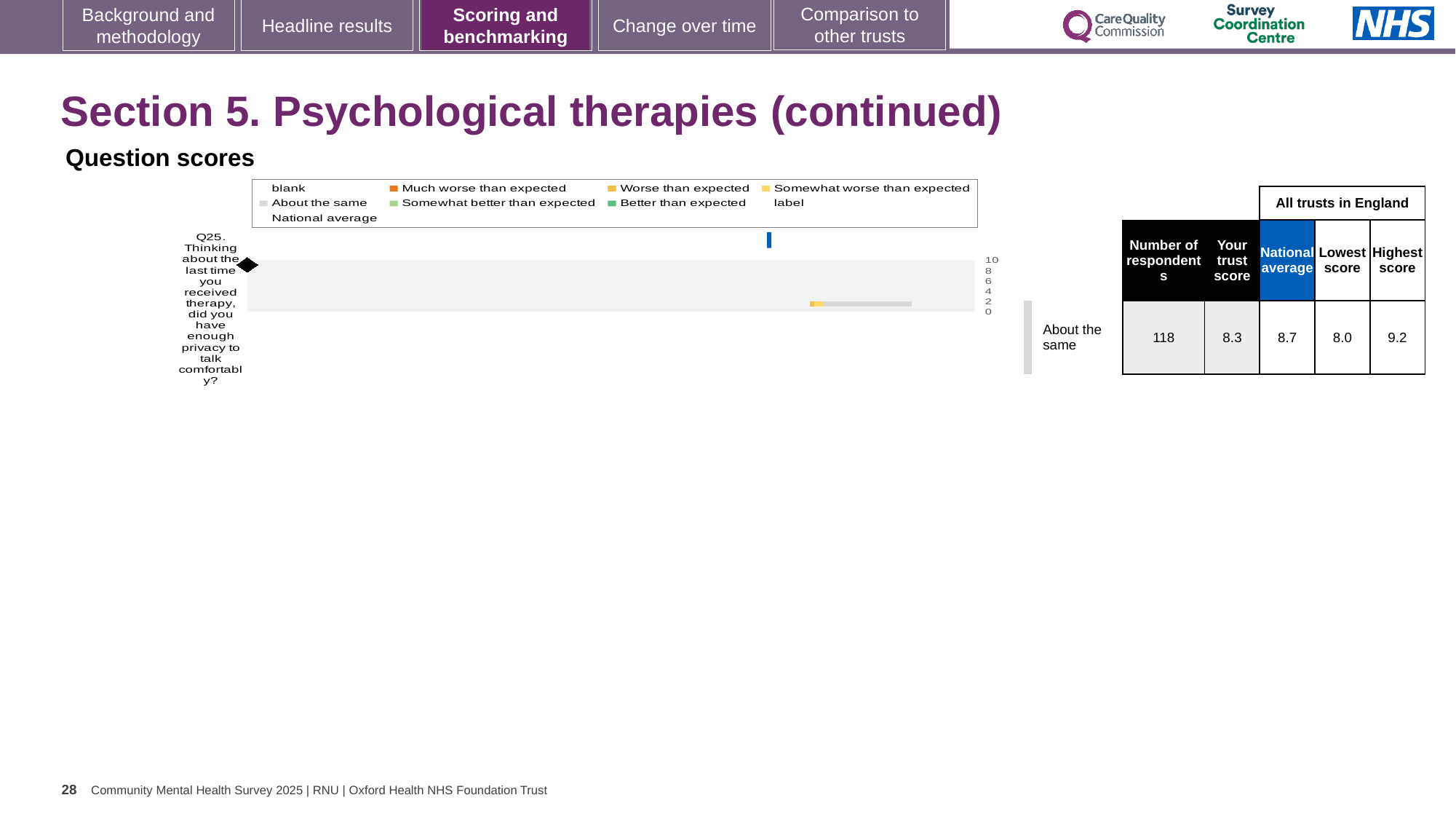
What is the difference between the highest score and the lowest score for Q25 in the table? 1.2 According to the label beside the chart, how is the trust's result for Q25 categorised? About the same Which question number is plotted in the chart? Q25 In the table beside the chart, what is the lowest score among all trusts in England for Q25? 8.0 In the table beside the chart, what is the national average for Q25? 8.7 Is the trust score for Q25 higher or lower than the national average? lower In the table beside the chart, what is 'Your trust score' for Q25? 8.3 How many questions (categories) are plotted in the chart? 1 In the table beside the chart, what is the number of respondents for Q25? 118 In the table beside the chart, what is the highest score among all trusts in England for Q25? 9.2 What is the highest value shown on the chart's axis? 10 What kind of chart is shown under 'Question scores'? bar chart